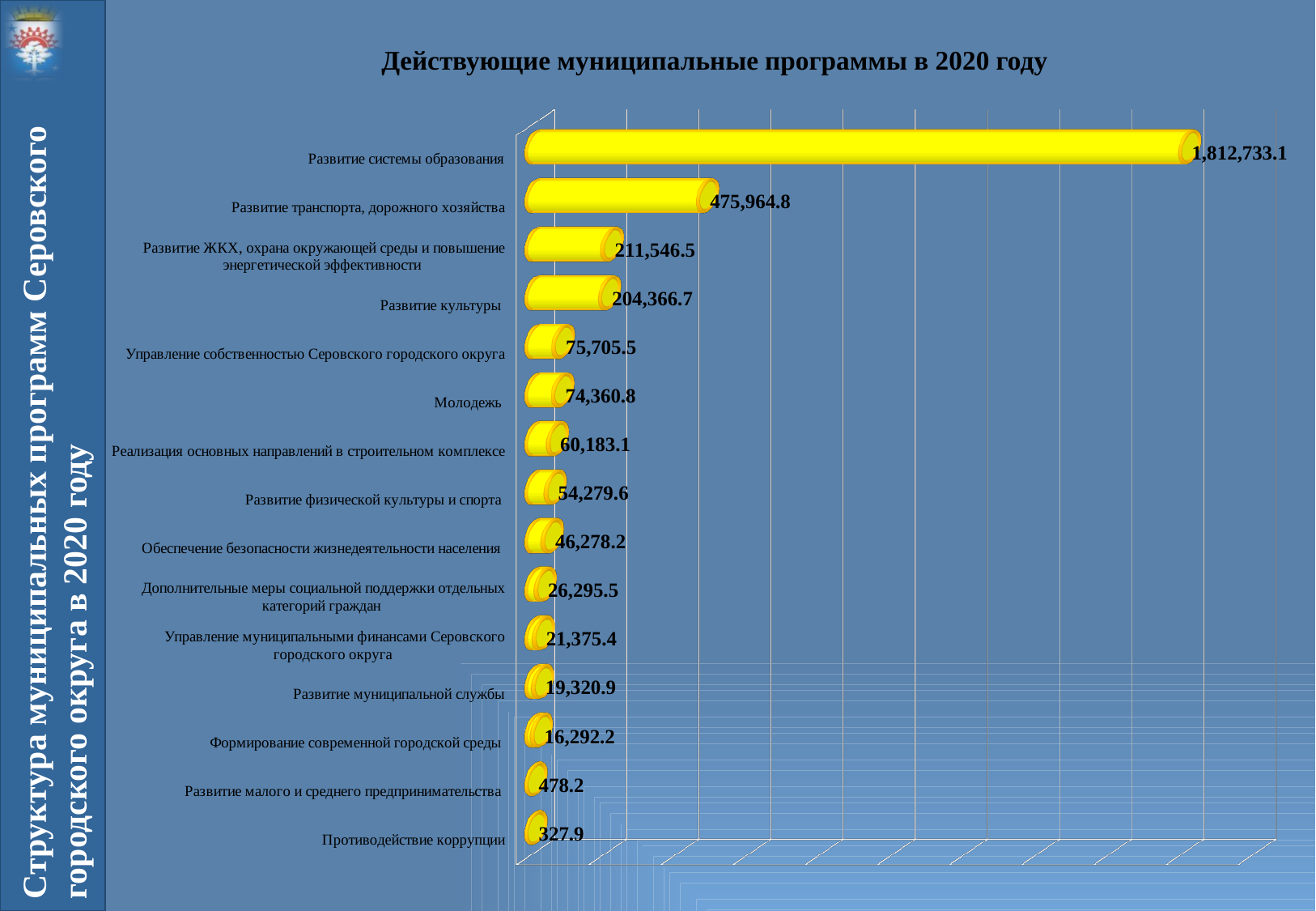
What is the title of the chart? Действующие муниципальные программы в 2020 году What is the value for "Развитие системы образования"? 1,812,733.1 How many municipal programmes (categories) are plotted in the chart? 15 What is the difference between the values for "Развитие малого и среднего предпринимательства" and "Противодействие коррупции"? 150.3 What is the difference between the values for "Развитие транспорта, дорожного хозяйства" and "Развитие ЖКХ, охрана окружающей среды и повышение энергетической эффективности"? 264,418.3 Which is larger: the value for "Управление собственностью Серовского городского округа" or for "Молодежь"? Управление собственностью Серовского городского округа What is the value for "Молодежь"? 74,360.8 Which programme has the lowest value? Противодействие коррупции What kind of chart is shown on the slide? bar chart What is the value for "Формирование современной городской среды"? 16,292.2 Which programme has the highest value? Развитие системы образования What is the value for "Развитие культуры"? 204,366.7